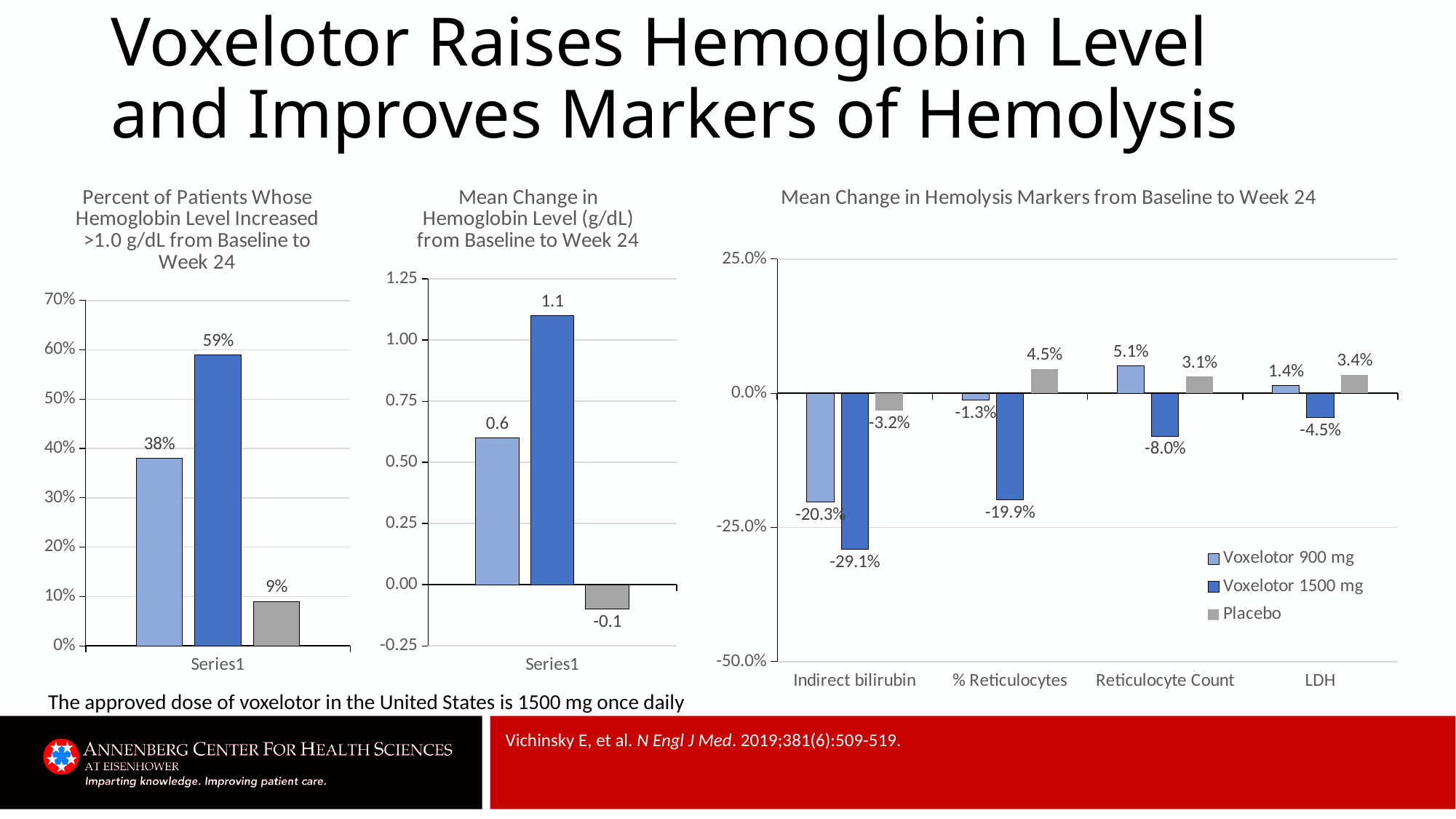
In the chart titled 'Mean Change in Hemoglobin Level (g/dL) from Baseline to Week 24', how many bars are plotted? 3 In the chart titled 'Percent of Patients Whose Hemoglobin Level Increased >1.0 g/dL from Baseline to Week 24', what is the highest value shown? 59% In the chart titled 'Mean Change in Hemolysis Markers from Baseline to Week 24', what is the value for Voxelotor 1500 mg for Indirect bilirubin? -29.1% In the chart titled 'Mean Change in Hemolysis Markers from Baseline to Week 24', how many series does the legend list? 3 In the chart titled 'Mean Change in Hemoglobin Level (g/dL) from Baseline to Week 24', what is the lowest value shown? -0.1 What kind of chart is the chart titled 'Mean Change in Hemolysis Markers from Baseline to Week 24'? Bar chart In the chart titled 'Mean Change in Hemoglobin Level (g/dL) from Baseline to Week 24', what is the value of the dark blue bar? 1.1 In the chart titled 'Mean Change in Hemolysis Markers from Baseline to Week 24', what is the value for Placebo for % Reticulocytes? 4.5% In the chart titled 'Mean Change in Hemolysis Markers from Baseline to Week 24', which is larger for LDH: Voxelotor 900 mg or Placebo? Placebo In the chart titled 'Percent of Patients Whose Hemoglobin Level Increased >1.0 g/dL from Baseline to Week 24', what is the value of the gray bar? 9% In the chart titled 'Percent of Patients Whose Hemoglobin Level Increased >1.0 g/dL from Baseline to Week 24', what is the difference between the dark blue bar and the light blue bar? 21% In the chart titled 'Mean Change in Hemolysis Markers from Baseline to Week 24', which category has the lowest value for Voxelotor 900 mg? Indirect bilirubin